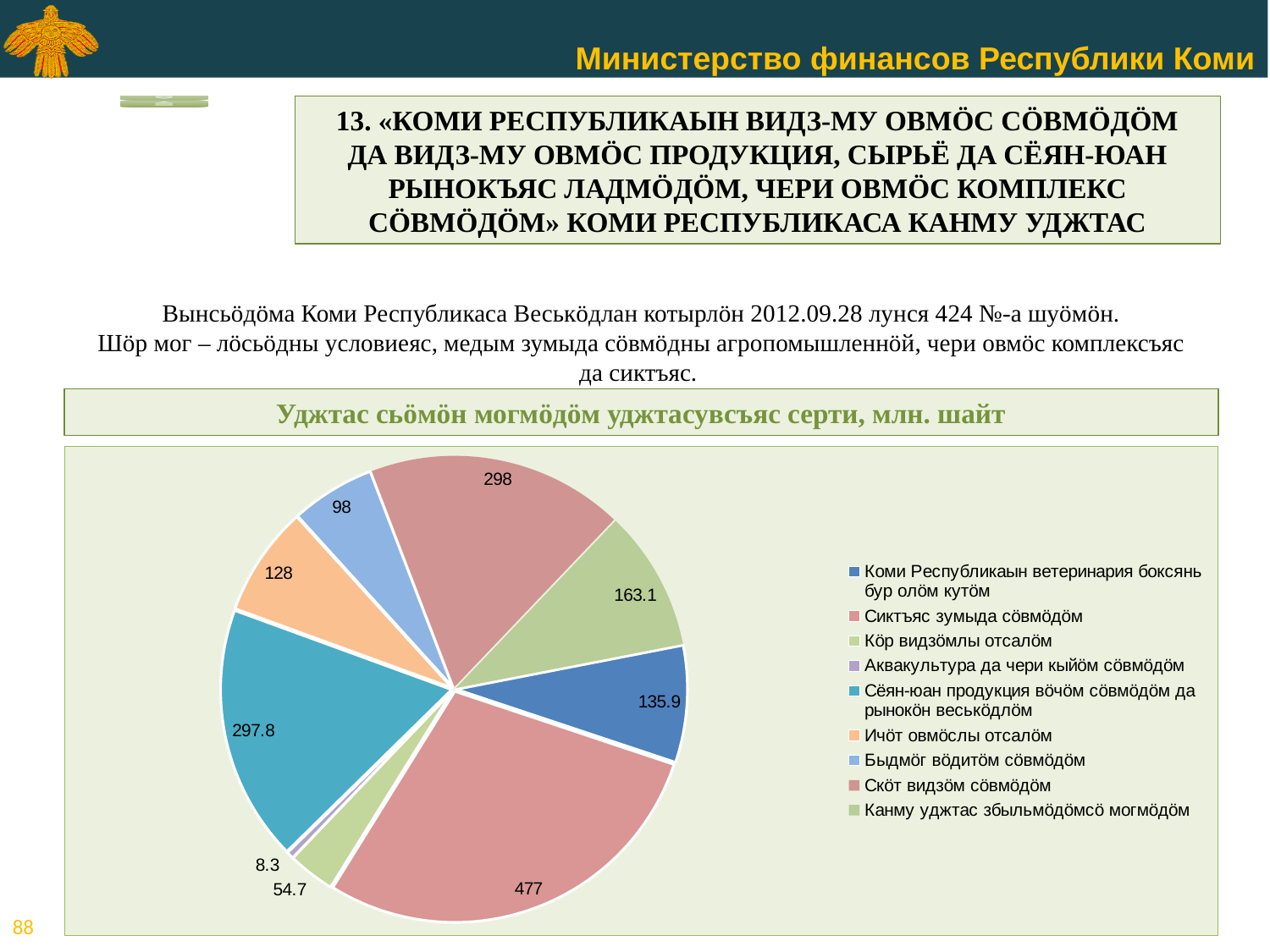
How many slices does the pie chart have? 9 Which category has the largest slice of the pie? Сиктъяс зумыда сӧвмӧдӧм What is the difference between the values for Сиктъяс зумыда сӧвмӧдӧм and Скӧт видзӧм сӧвмӧдӧм? 179 Which category has the smallest slice of the pie? Аквакультура да чери кыйӧм сӧвмӧдӧм What is the title of the chart? Уджтас сьӧмӧн могмӧдӧм уджтасувсъяс серти, млн. шайт What is the value for Аквакультура да чери кыйӧм сӧвмӧдӧм? 8.3 What is the value for Сиктъяс зумыда сӧвмӧдӧм? 477 What is the value for Сёян-юан продукция вӧчӧм сӧвмӧдӧм да рынокӧн веськӧдлӧм? 297.8 What type of chart is shown on the slide? pie chart What is the value for Коми Республикаын ветеринария боксянь бур олӧм кутӧм? 135.9 Which is larger, the value for Ичӧт овмӧслы отсалӧм or the value for Быдмӧг вӧдитӧм сӧвмӧдӧм? Ичӧт овмӧслы отсалӧм What is the difference between the values for Канму уджтас збыльмӧдӧмсӧ могмӧдӧм and Кӧр видзӧмлы отсалӧм? 108.4